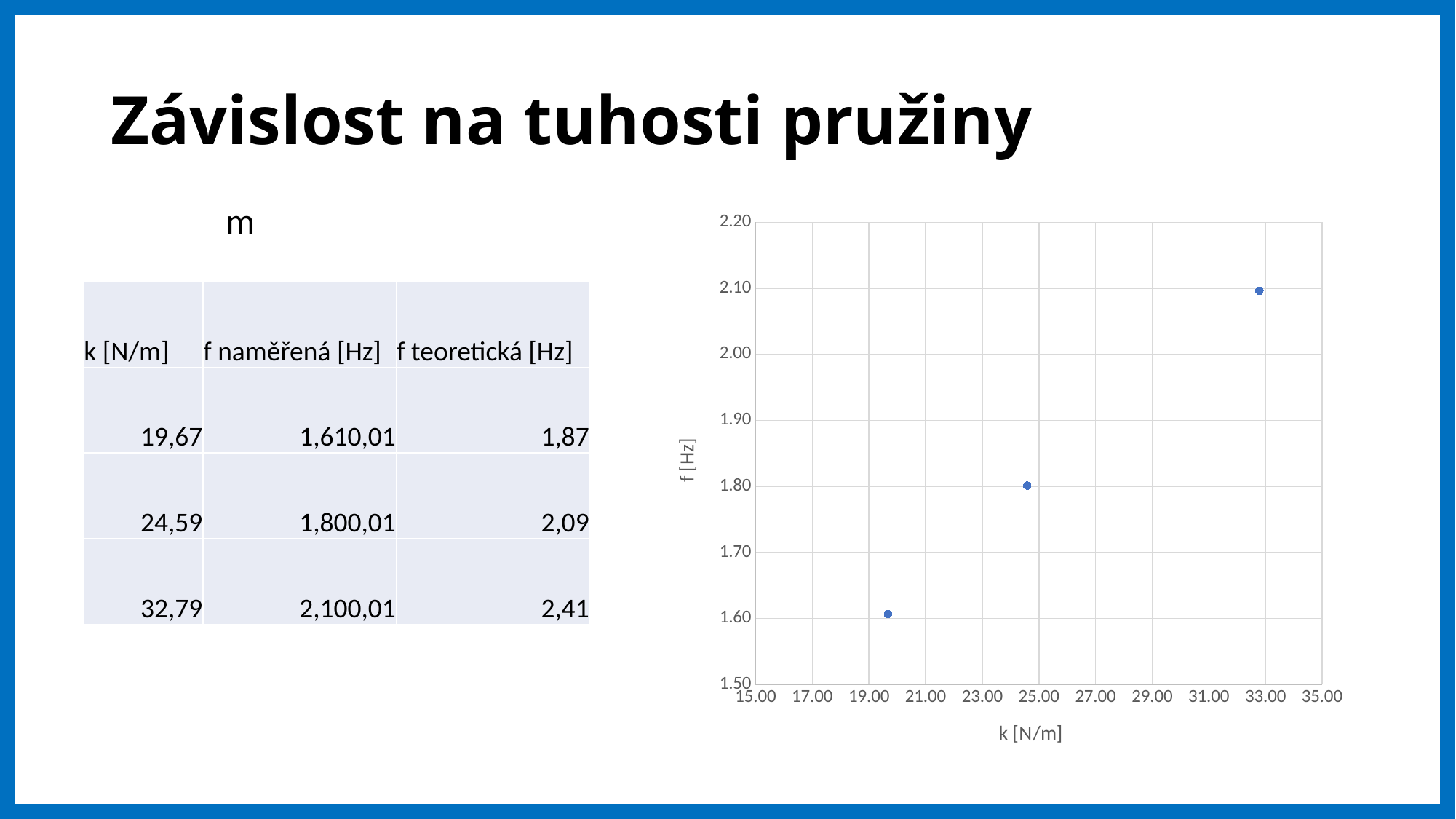
Is the k value of the rightmost point greater or less than 31.00? greater Is the f value of the rightmost point (near k = 32.79) greater or less than 2.00? greater What kind of chart is shown on the slide? scatter chart Is the f value of the middle point larger or smaller than that of the leftmost point? larger Is the f value of the middle point (near k = 24.59) greater or less than 1.90? less Which point has the lowest f value: the leftmost, middle, or rightmost point? leftmost Which point has the highest f value: the one at the lowest k or the one at the highest k? the one at the highest k How many data points are plotted on the chart? 3 Do the plotted values of f rise or fall as k increases along the x axis? rise What is the title of the chart's x axis? k [N/m] What is the title of the chart's y axis? f [Hz]